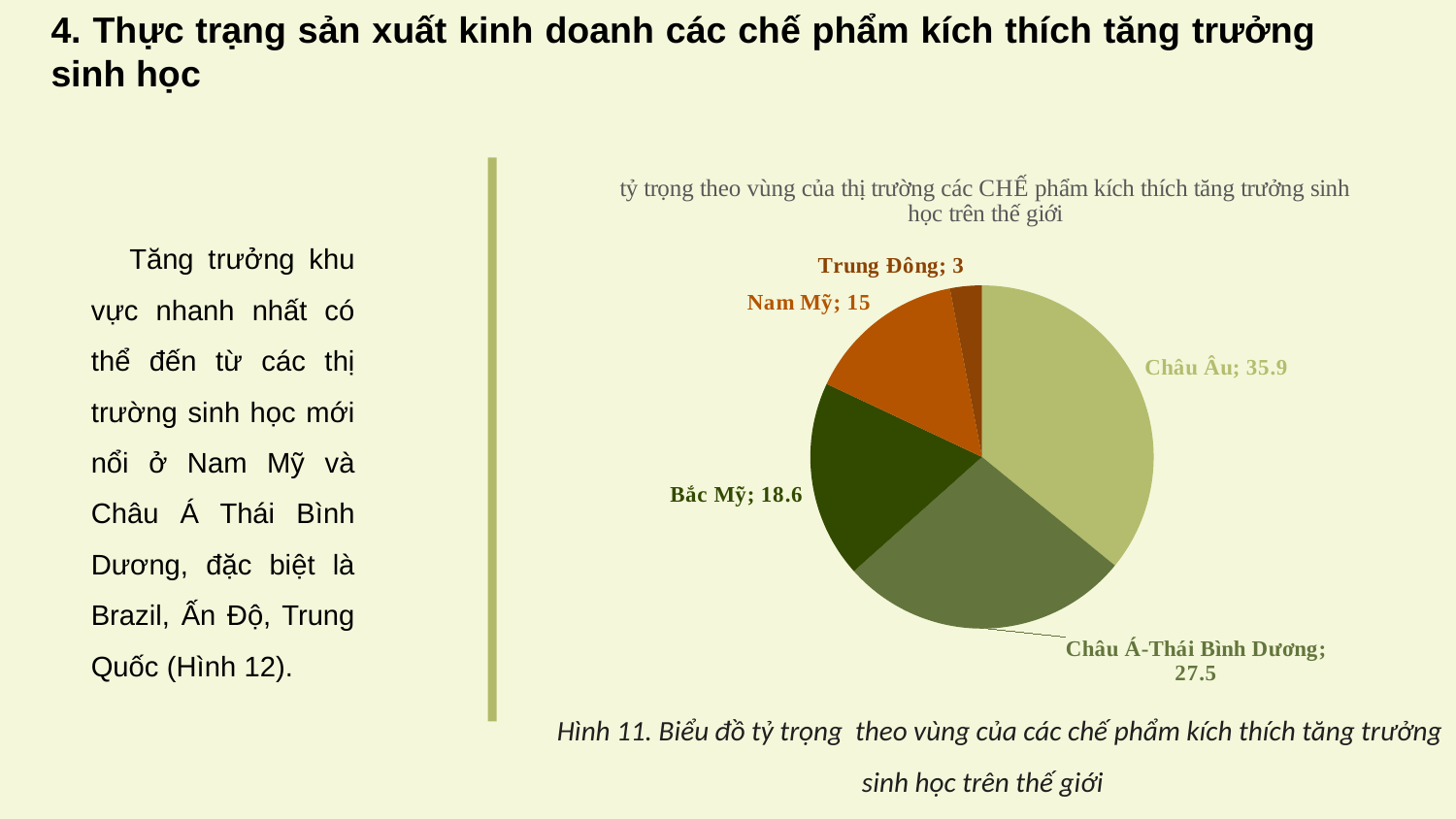
Which is larger, the value for Bắc Mỹ or the value for Nam Mỹ? Bắc Mỹ What kind of chart is shown on the slide? pie chart How many regions (slices) are shown in the pie chart? 5 What is the value for Trung Đông in the pie chart? 3 What share of the pie does the Châu Âu slice represent? 35.9 Which region has the largest slice of the pie chart? Châu Âu Which region has the smallest slice of the pie chart? Trung Đông What is the value for Châu Âu in the pie chart? 35.9 What is the value for Châu Á-Thái Bình Dương in the pie chart? 27.5 What is the value for Bắc Mỹ in the pie chart? 18.6 What is the value for Nam Mỹ in the pie chart? 15 What is the difference between the values for Châu Âu and Châu Á-Thái Bình Dương? 8.4